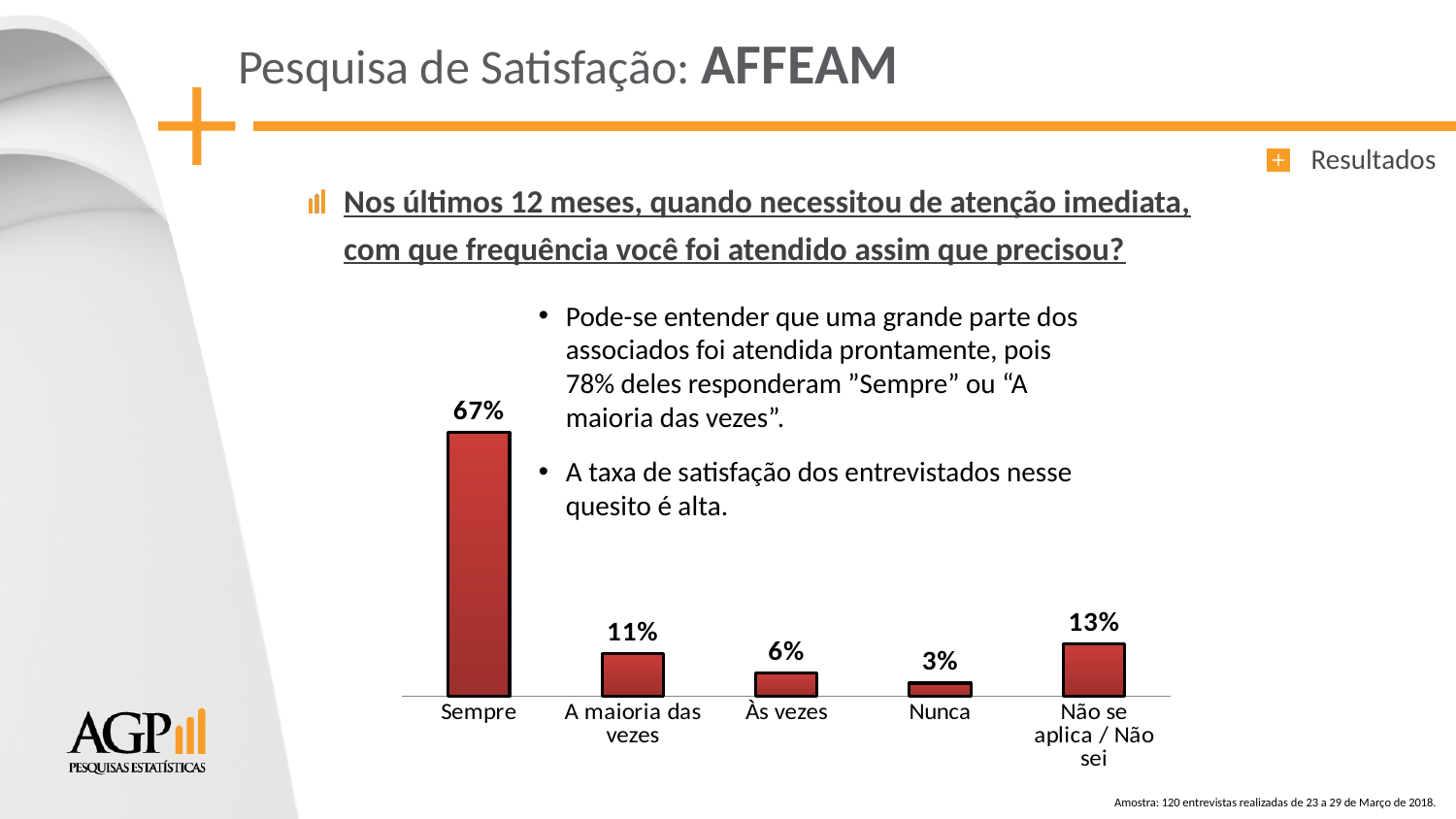
Which category has the highest value? Sempre What is the value for "Não se aplica / Não sei"? 13% What is the difference between the values for "Sempre" and "A maioria das vezes"? 56% Which category has the lowest value? Nunca Which is larger, the value for "A maioria das vezes" or the value for "Não se aplica / Não sei"? Não se aplica / Não sei What is the value for "A maioria das vezes"? 11% What is the difference between the values for "Não se aplica / Não sei" and "Às vezes"? 7% What is the value for "Sempre"? 67% What is the value for "Nunca"? 3% What colour are the bars in the chart? Red How many categories are shown on the chart? 5 What kind of chart is shown on the slide? Bar chart